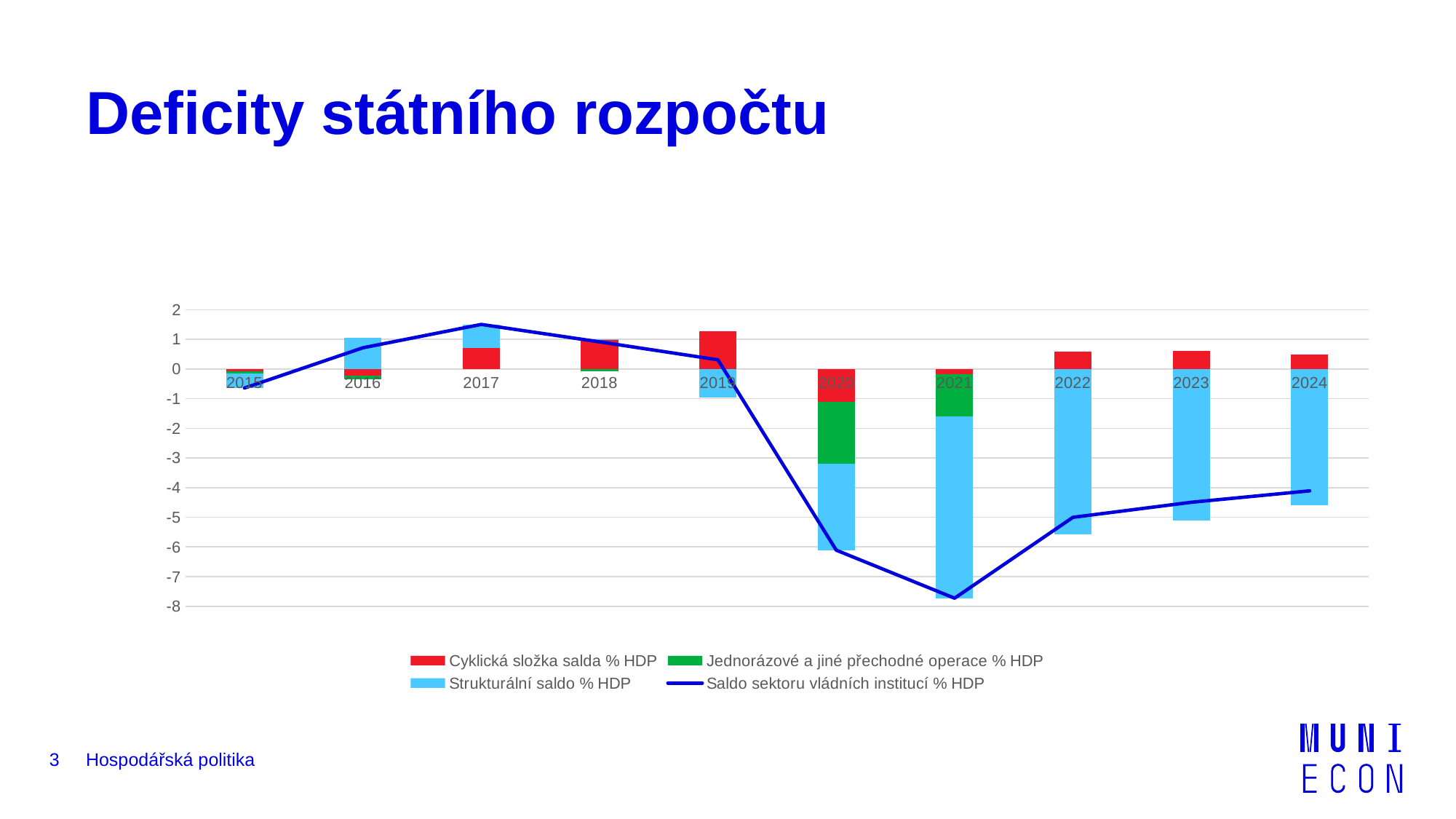
How many series does the chart legend list? 4 In which year does the line 'Saldo sektoru vládních institucí % HDP' reach its lowest value? 2021 How many years are shown on the x axis of the chart? 10 In which year does the line 'Saldo sektoru vládních institucí % HDP' reach its highest value? 2017 Which year has the larger value of the line 'Saldo sektoru vládních institucí % HDP', 2020 or 2021? 2020 Does the line 'Saldo sektoru vládních institucí % HDP' rise or fall from 2021 to 2024? rise Is the value of the line 'Saldo sektoru vládních institucí % HDP' for 2021 greater or less than -7? less Which legend entry is drawn as a line rather than bars? Saldo sektoru vládních institucí % HDP Is the value of 'Strukturální saldo % HDP' for 2022 greater or less than -5? less What kind of chart is shown on the slide? A stacked bar chart with a line Is the value of the line 'Saldo sektoru vládních institucí % HDP' for 2017 greater or less than 1? greater What is the title of the slide containing the chart? Deficity státního rozpočtu